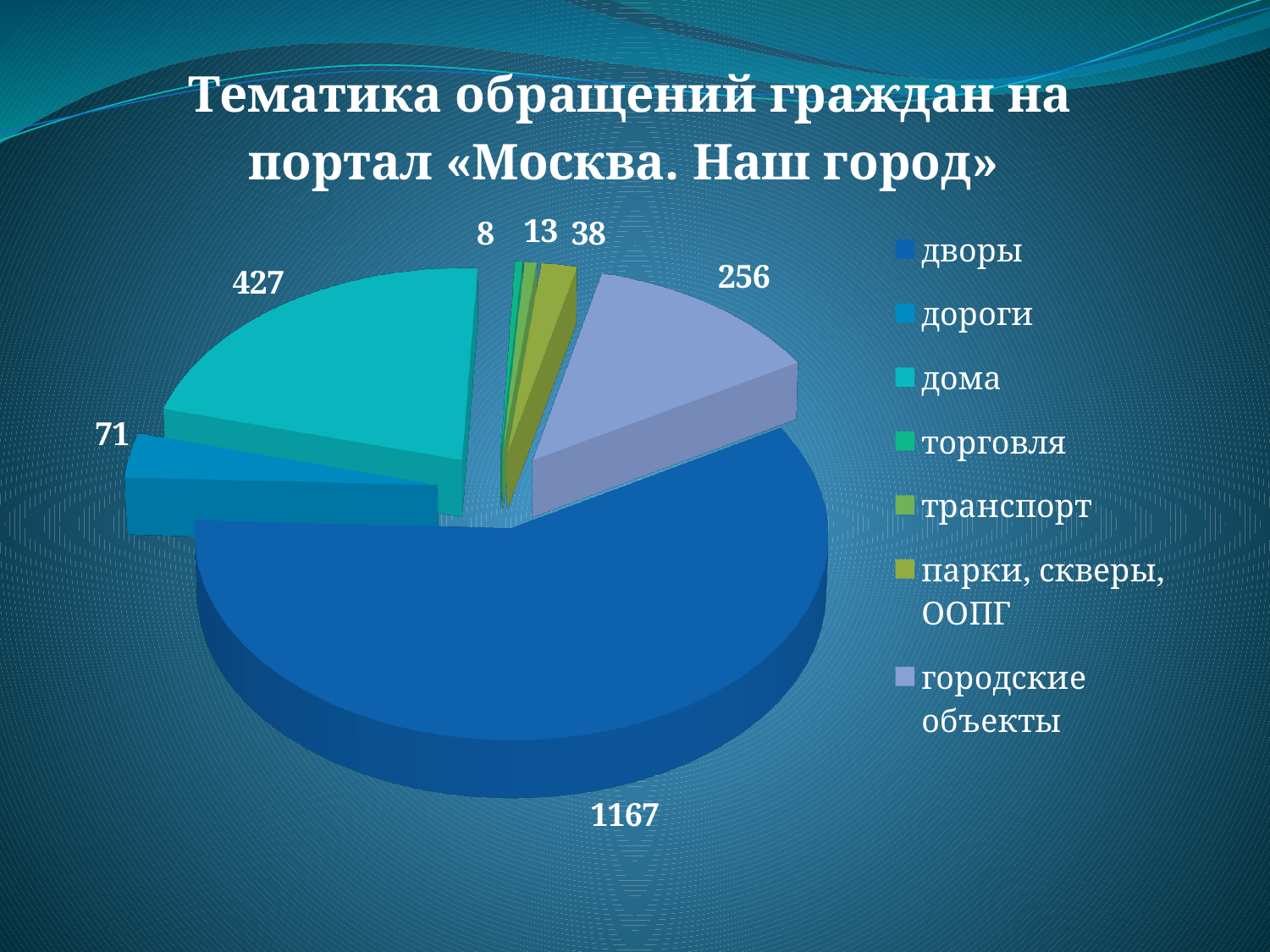
Which is larger, the value for транспорт or the value for парки, скверы, ООПГ? парки, скверы, ООПГ What is the value for дороги? 71 What is the value for дворы? 1167 What is the total of all the values in the pie chart? 1980 What is the title of the chart? Тематика обращений граждан на портал «Москва. Наш город» What is the difference between the values for дома and городские объекты? 171 Which category has the largest slice? дворы What is the value for городские объекты? 256 Which category has the smallest slice? торговля What is the value for дома? 427 What type of chart is shown on the slide? pie chart How many categories does the pie chart show? 7